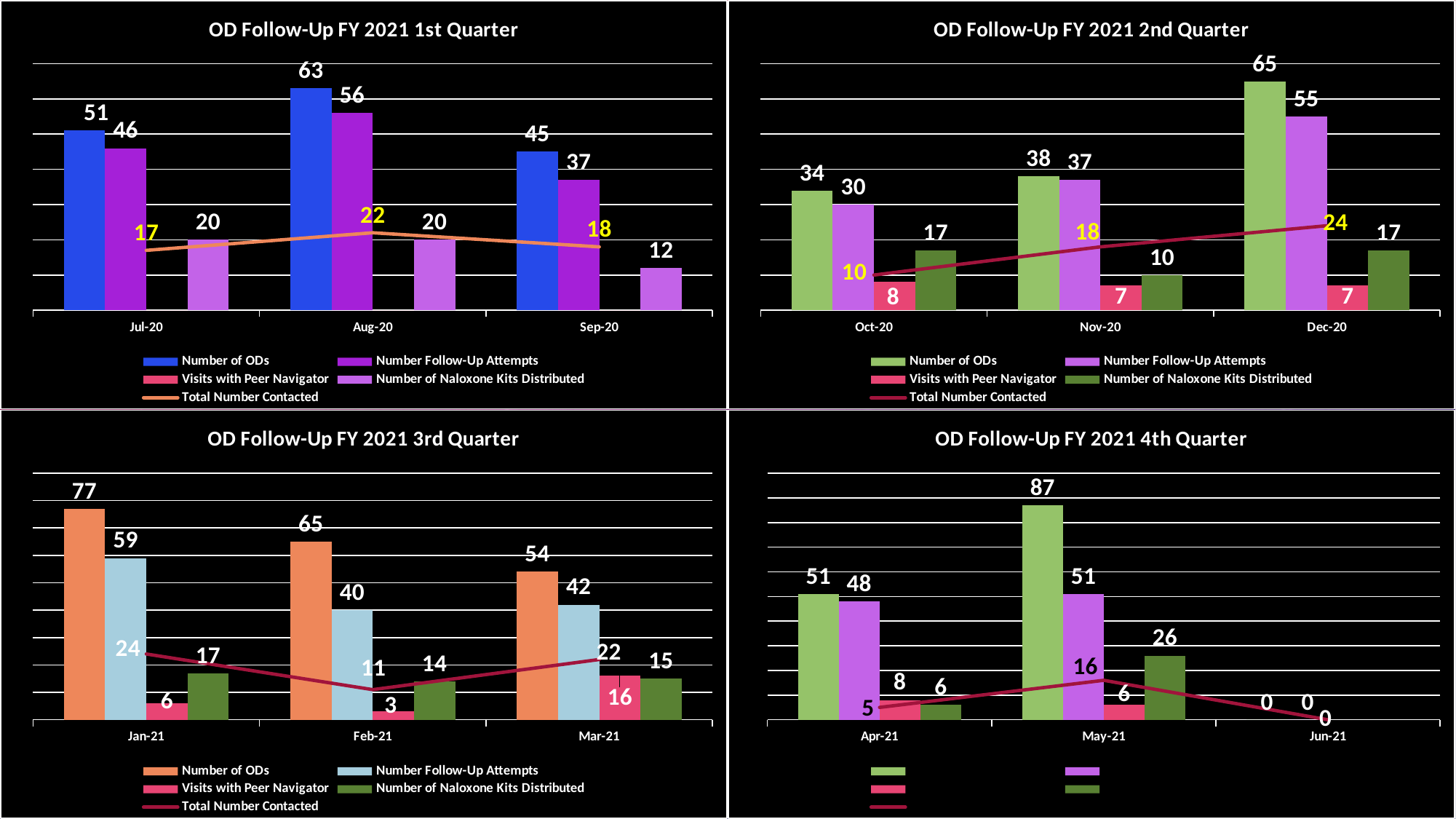
How many series does the legend of the OD Follow-Up FY 2021 3rd Quarter chart list? 5 In the OD Follow-Up FY 2021 2nd Quarter chart, what is the Total Number Contacted for Dec-20? 24 How many months are shown on the x axis of the OD Follow-Up FY 2021 4th Quarter chart? 3 In the OD Follow-Up FY 2021 1st Quarter chart, which month has the highest Number of Follow-Up Attempts? Aug-20 In the OD Follow-Up FY 2021 3rd Quarter chart, is the Number of ODs for Feb-21 larger or smaller than the Number of ODs for Mar-21? larger In the OD Follow-Up FY 2021 1st Quarter chart, what is the Number of ODs for Aug-20? 63 In the OD Follow-Up FY 2021 3rd Quarter chart, what is the Number of ODs for Jan-21? 77 In the OD Follow-Up FY 2021 2nd Quarter chart, which month has the lowest Number of Naloxone Kits Distributed? Nov-20 In the OD Follow-Up FY 2021 3rd Quarter chart, which month has the highest number of Visits with Peer Navigator? Mar-21 In the OD Follow-Up FY 2021 4th Quarter chart, what is the value of the tallest bar for May-21? 87 In the OD Follow-Up FY 2021 1st Quarter chart, what is the difference between the Number of ODs and the Number Follow-Up Attempts for Sep-20? 8 In the OD Follow-Up FY 2021 2nd Quarter chart, does the Total Number Contacted rise or fall from Oct-20 to Dec-20? rise